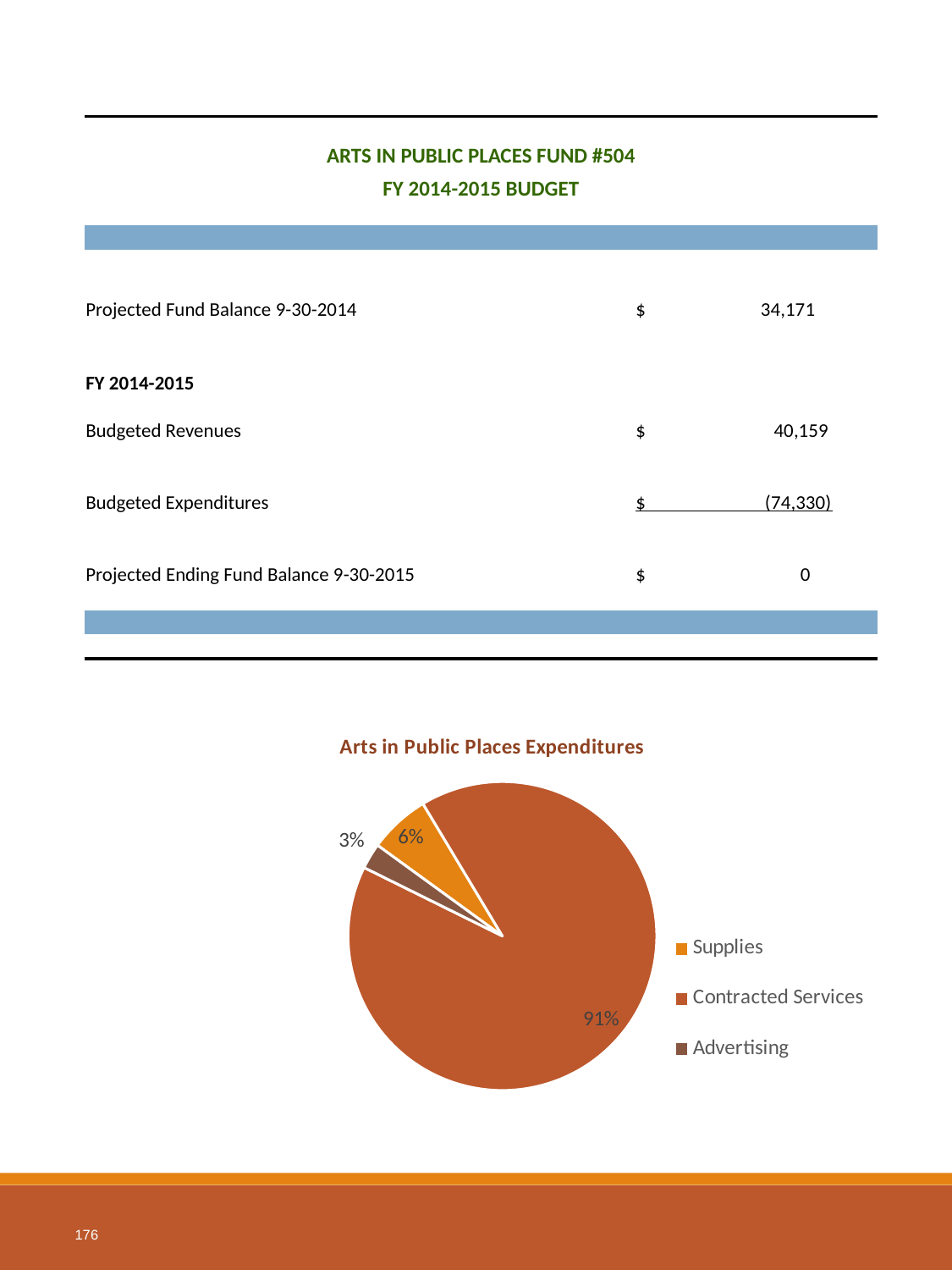
Which category has the smallest slice of the pie? Advertising Which category has the largest slice of the pie? Contracted Services What type of chart is shown on the slide? pie chart How many entries does the legend of the pie chart list? 3 Which legend entry is shown in brown? Advertising What share of the pie does Supplies represent? 6% Which is larger, the share for Supplies or the share for Advertising? Supplies How many categories does the pie chart show? 3 What share of the pie does Advertising represent? 3% What is the title of the chart on the slide? Arts in Public Places Expenditures What is the difference in percentage points between the Contracted Services share and the Supplies share? 85 What share of the pie does Contracted Services represent? 91%